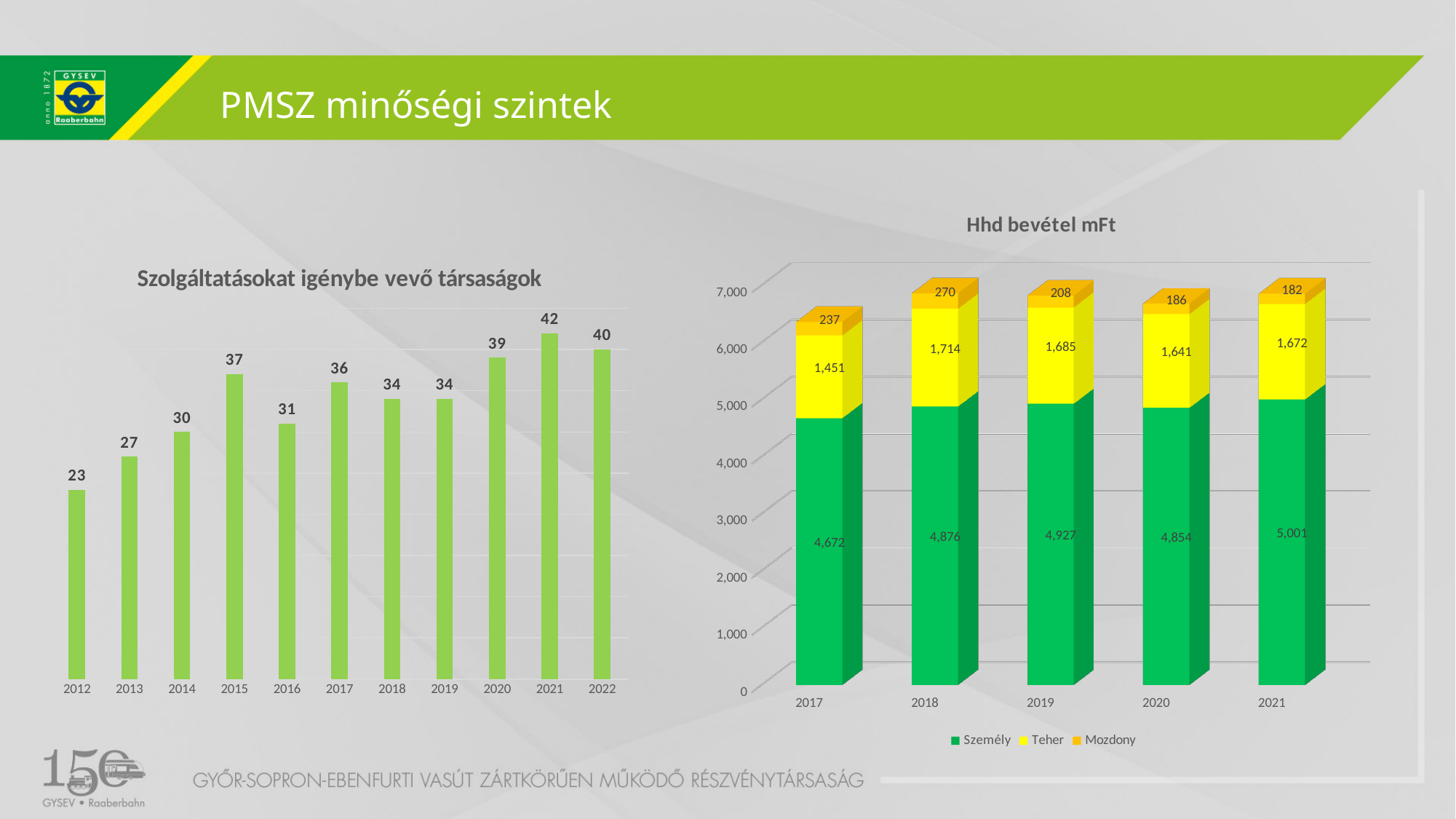
In the 'Hhd bevétel mFt' chart, what is the Teher value for 2019? 1,685 In the 'Szolgáltatásokat igénybe vevő társaságok' chart, which year has the lowest value? 2012 In the 'Szolgáltatásokat igénybe vevő társaságok' chart, how many years are shown on the x axis? 11 In the 'Hhd bevétel mFt' chart, what is the Személy value for 2021? 5,001 In the 'Hhd bevétel mFt' chart, which year has the highest Mozdony value? 2018 In the 'Szolgáltatásokat igénybe vevő társaságok' chart, is the value for 2016 larger or smaller than the value for 2017? smaller In the 'Szolgáltatásokat igénybe vevő társaságok' chart, what is the value for 2015? 37 In the 'Hhd bevétel mFt' chart, what is the total of the stacked bar for 2017? 6,360 What kind of chart is the 'Hhd bevétel mFt' chart? stacked bar chart In the 'Szolgáltatásokat igénybe vevő társaságok' chart, which year has the highest value? 2021 In the 'Hhd bevétel mFt' chart, how many series does the legend list? 3 In the 'Szolgáltatásokat igénybe vevő társaságok' chart, what is the difference between the values for 2022 and 2012? 17